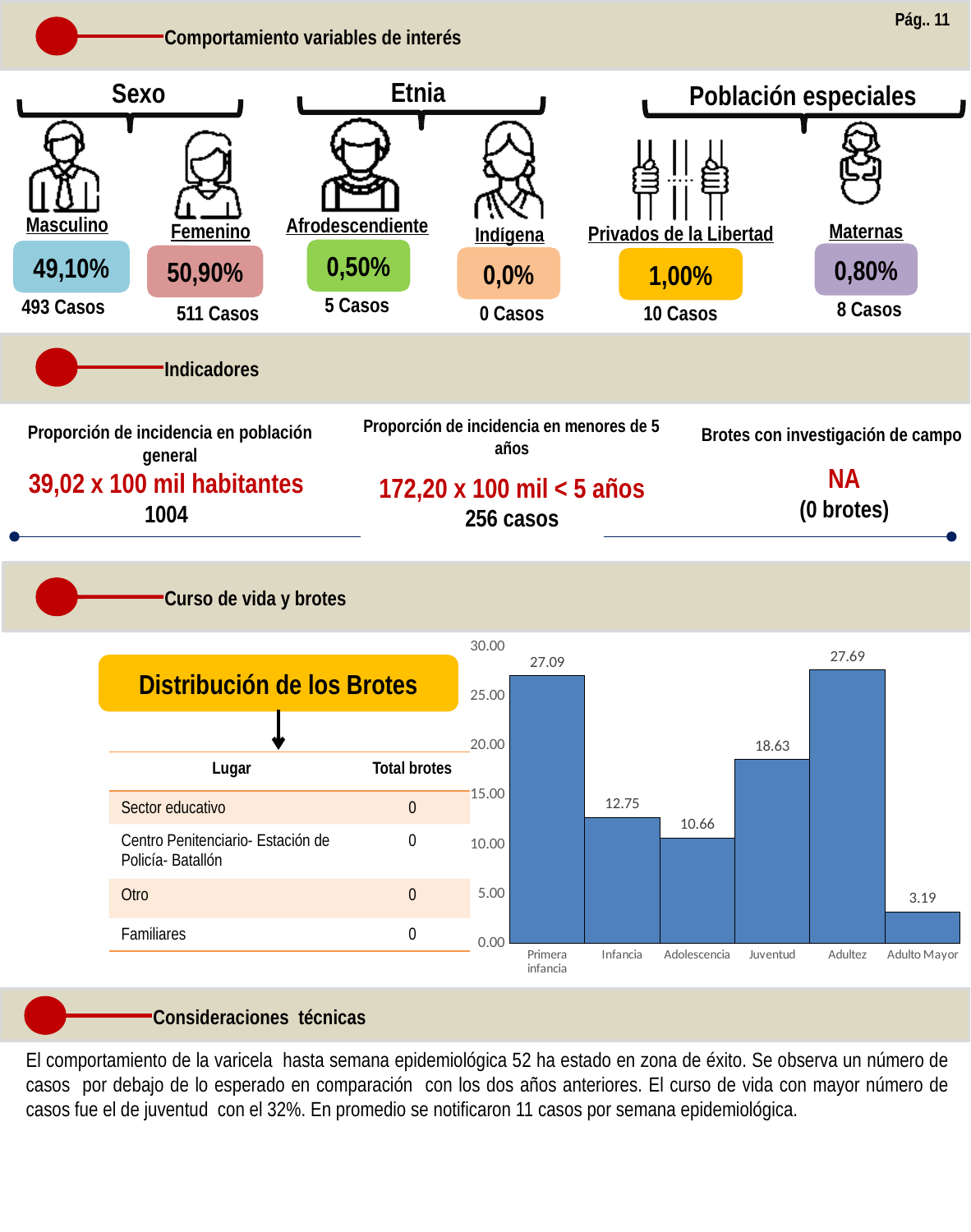
In the bar chart, what is the value for Juventud? 18.63 In the bar chart, what is the difference between the values for Juventud and Infancia? 5.88 In the bar chart, which is larger: the value for Infancia or the value for Adolescencia? Infancia In the bar chart, what is the value for Adolescencia? 10.66 In the bar chart, which category has the lowest value? Adulto Mayor What type of chart is shown in the 'Curso de vida y brotes' section? bar chart In the bar chart, what is the value for Primera infancia? 27.09 In the bar chart, which category has the highest value? Adultez In the bar chart, what is the difference between the values for Adultez and Primera infancia? 0.60 In the bar chart, is the value for Juventud greater or less than 20.00? less How many categories are shown on the x axis of the bar chart? 6 In the bar chart, what is the value for Adulto Mayor? 3.19